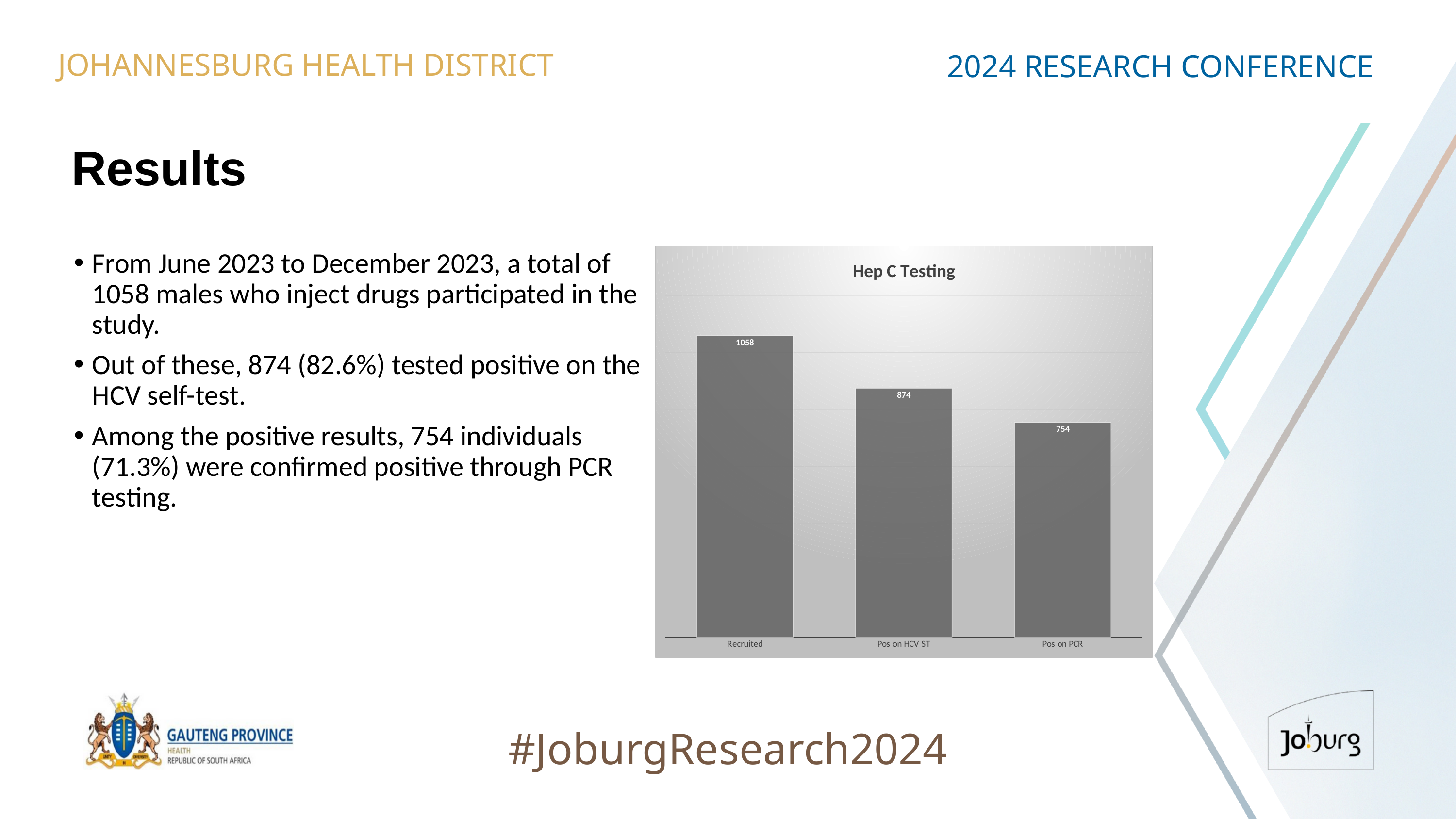
Which category has the highest value in the Hep C Testing chart? Recruited Which is larger, the value for Pos on HCV ST or the value for Pos on PCR? Pos on HCV ST What is the value for Pos on HCV ST in the Hep C Testing chart? 874 How many categories are shown in the Hep C Testing chart? 3 Do the values rise or fall from left to right across the Hep C Testing chart? fall What is the title of the chart on the slide? Hep C Testing What is the difference between the Pos on HCV ST value and the Pos on PCR value? 120 What is the difference between the Recruited value and the Pos on HCV ST value? 184 What is the value for Pos on PCR in the Hep C Testing chart? 754 What is the value for Recruited in the Hep C Testing chart? 1058 What kind of chart is the Hep C Testing chart? bar chart Which category has the lowest value in the Hep C Testing chart? Pos on PCR